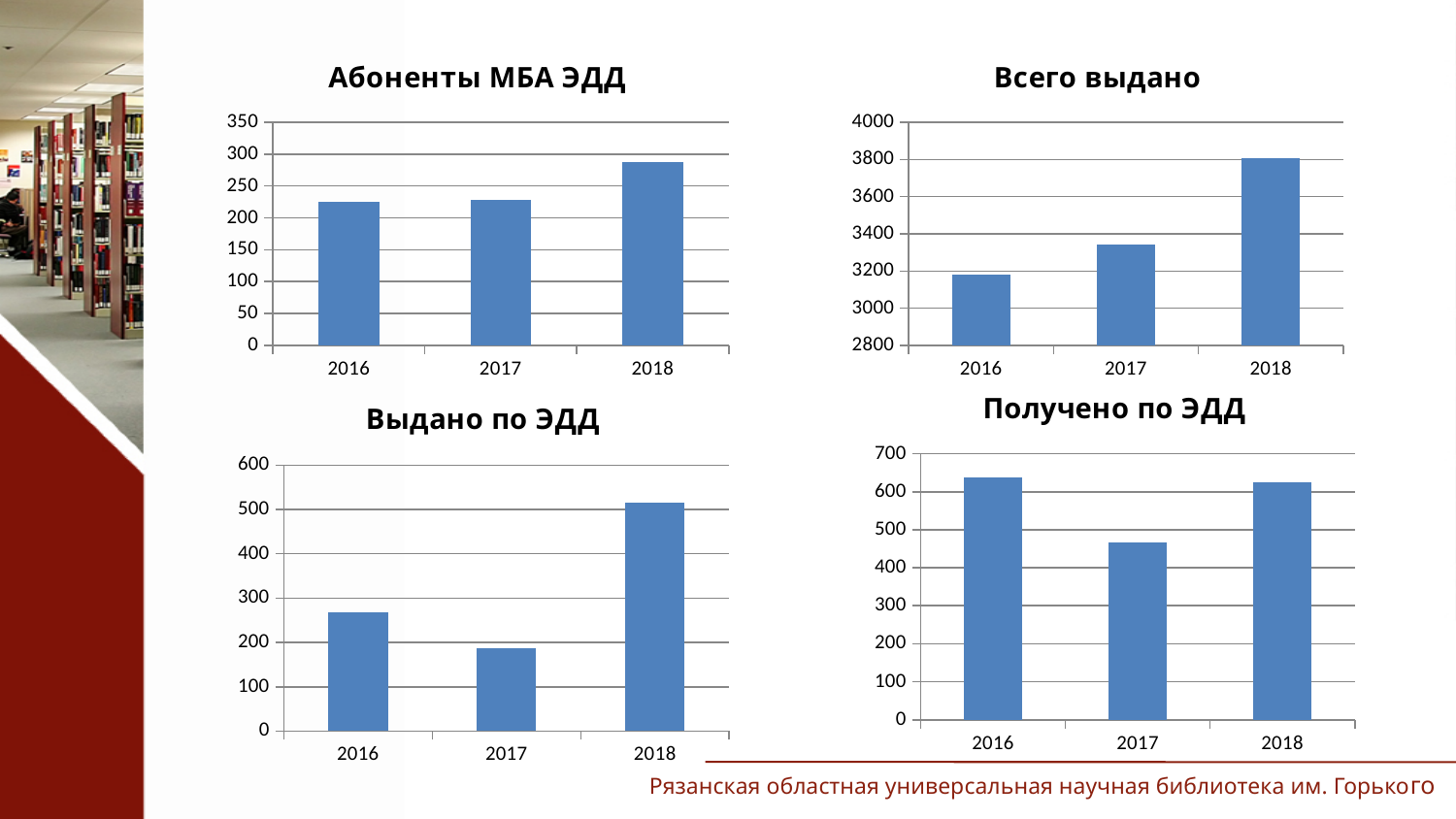
In the chart titled "Абоненты МБА ЭДД", is the value for 2018 greater or less than 250? greater In the chart titled "Выдано по ЭДД", which is larger, the value for 2016 or the value for 2017? 2016 In the chart titled "Абоненты МБА ЭДД", how many years are shown on the x axis? 3 In the chart titled "Абоненты МБА ЭДД", which year has the highest value? 2018 In the chart titled "Получено по ЭДД", is the value for 2017 greater or less than 500? less In the chart titled "Всего выдано", is the value for 2018 greater or less than 3600? greater In the chart titled "Всего выдано", do the values rise or fall from 2016 to 2018? rise What kind of chart is the chart titled "Получено по ЭДД"? bar chart In the chart titled "Получено по ЭДД", which year has the lowest value? 2017 In the chart titled "Выдано по ЭДД", which year has the lowest value? 2017 In the chart titled "Всего выдано", which year has the lowest value? 2016